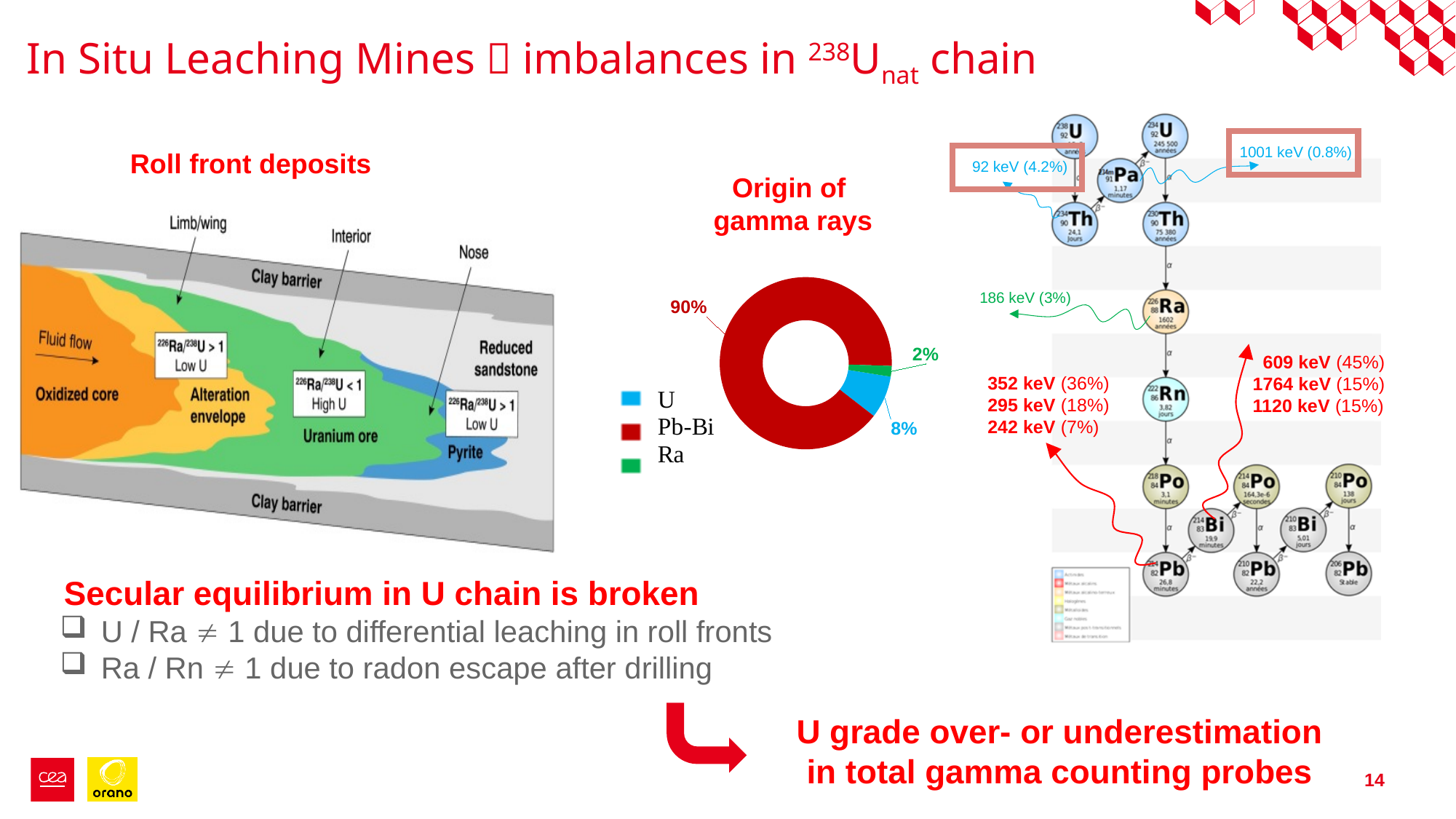
In the "Origin of gamma rays" chart, what share of gamma rays comes from U? 8% In the "Origin of gamma rays" chart, which source has the smallest share? Ra In the "Origin of gamma rays" chart, what colour is the Pb-Bi slice? dark red What is the title of the pie chart on the slide? Origin of gamma rays In the "Origin of gamma rays" chart, which source has the largest share? Pb-Bi In the "Origin of gamma rays" chart, which has a larger share, U or Ra? U In the "Origin of gamma rays" chart, what is the difference between the Pb-Bi share and the U share? 82% How many slices does the "Origin of gamma rays" chart have? 3 How many entries does the legend of the "Origin of gamma rays" chart list? 3 What kind of chart is the "Origin of gamma rays" chart? pie chart (donut) In the "Origin of gamma rays" chart, what share of gamma rays comes from Pb-Bi? 90% In the "Origin of gamma rays" chart, what share of gamma rays comes from Ra? 2%